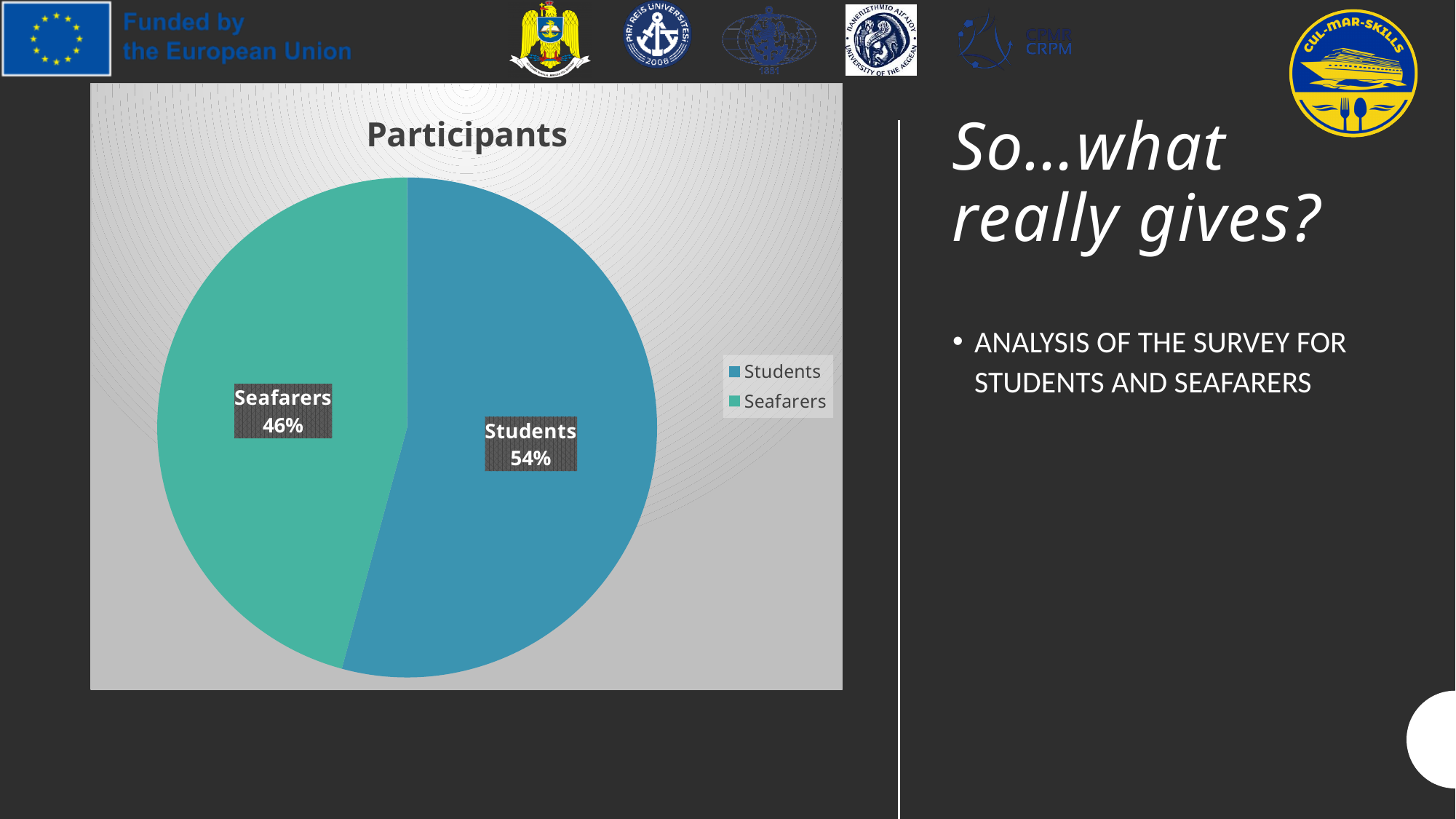
What is the difference in percentage points between the Students and Seafarers shares? 8 How many entries does the legend list? 2 How many slices does the pie chart have? 2 What is the title of the chart? Participants Which is larger, the share for Students or the share for Seafarers? Students What kind of chart is shown on the slide? pie chart Which category has the largest share of the pie? Students What share of participants are Students? 54% Which colour represents Seafarers in the pie chart? green Is the share for Students greater or less than 50%? greater Which category has the smallest share of the pie? Seafarers What share of participants are Seafarers? 46%